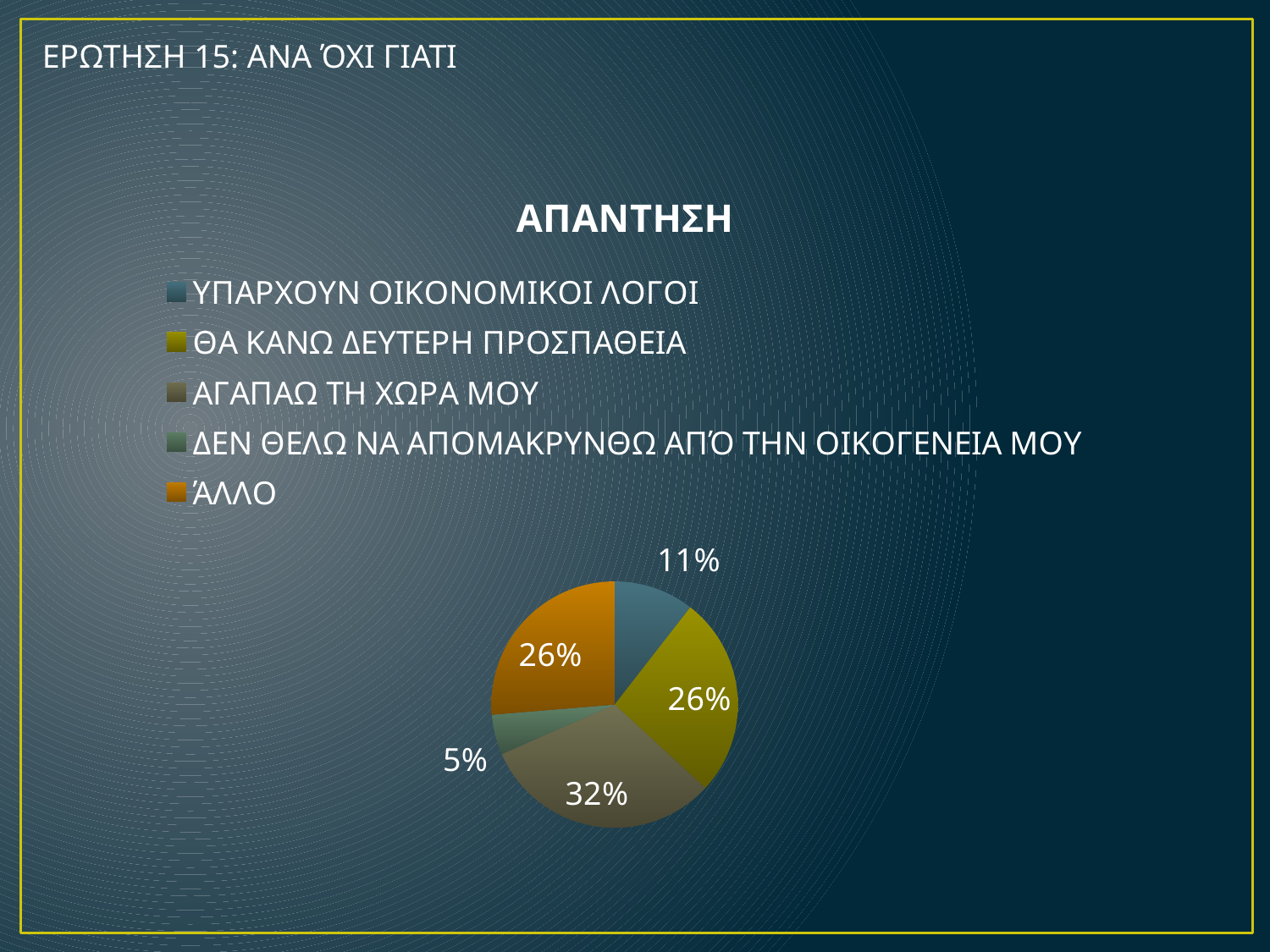
What is the title of the chart? ΑΠΑΝΤΗΣΗ What kind of chart is shown on the slide? pie chart What is the difference in percentage points between ΑΓΑΠΑΩ ΤΗ ΧΩΡΑ ΜΟΥ and ΥΠΑΡΧΟΥΝ ΟΙΚΟΝΟΜΙΚΟΙ ΛΟΓΟΙ? 21 What percentage is shown for ΔΕΝ ΘΕΛΩ ΝΑ ΑΠΟΜΑΚΡΥΝΘΩ ΑΠΌ ΤΗΝ ΟΙΚΟΓΕΝΕΙΑ ΜΟΥ? 5% What percentage is shown for ΥΠΑΡΧΟΥΝ ΟΙΚΟΝΟΜΙΚΟΙ ΛΟΓΟΙ? 11% What percentage is shown for ΑΓΑΠΑΩ ΤΗ ΧΩΡΑ ΜΟΥ? 32% What colour is the slice for ΆΛΛΟ? orange Which is larger, the share for ΆΛΛΟ or the share for ΥΠΑΡΧΟΥΝ ΟΙΚΟΝΟΜΙΚΟΙ ΛΟΓΟΙ? ΆΛΛΟ What percentage is shown for ΘΑ ΚΑΝΩ ΔΕΥΤΕΡΗ ΠΡΟΣΠΑΘΕΙΑ? 26% Which category has the largest share of the pie? ΑΓΑΠΑΩ ΤΗ ΧΩΡΑ ΜΟΥ Which category has the smallest share of the pie? ΔΕΝ ΘΕΛΩ ΝΑ ΑΠΟΜΑΚΡΥΝΘΩ ΑΠΌ ΤΗΝ ΟΙΚΟΓΕΝΕΙΑ ΜΟΥ How many categories does the legend of the pie chart list? 5